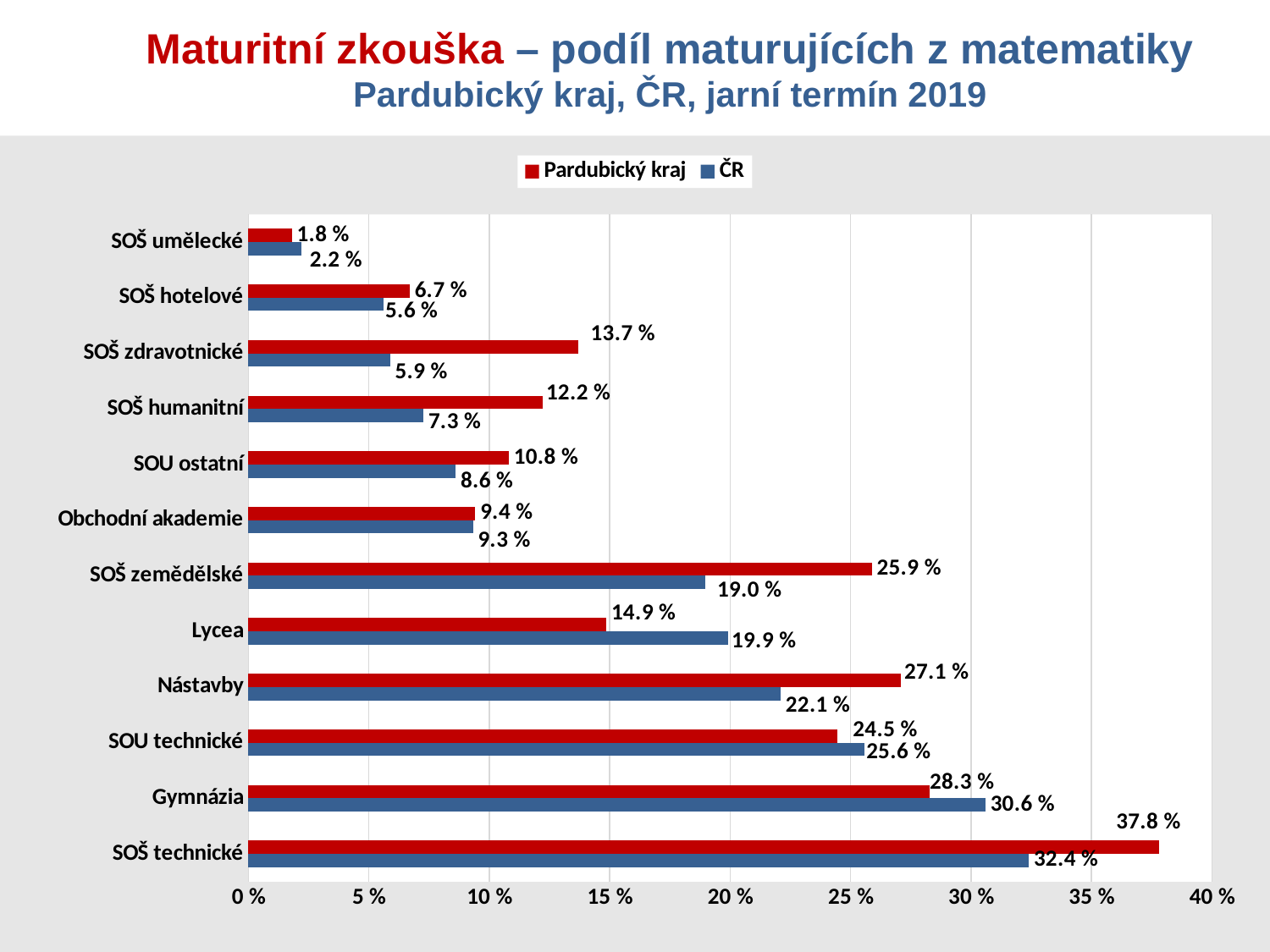
Which category has the lowest value for ČR? SOŠ umělecké What is the value for Pardubický kraj for SOŠ zdravotnické? 13.7 % What is the difference between the Pardubický kraj and ČR values for Nástavby? 5.0 % Is the Pardubický kraj value for SOŠ zemědělské greater or less than 25 %? greater For SOU technické, which is larger: the Pardubický kraj value or the ČR value? ČR Which colour represents the ČR series in the chart? blue What is the value for ČR for Lycea? 19.9 % Which category has the highest value for Pardubický kraj? SOŠ technické What is the value for ČR for Gymnázia? 30.6 % How many series does the legend list? 2 What kind of chart is shown on the slide? bar chart How many school categories are plotted on the chart? 12